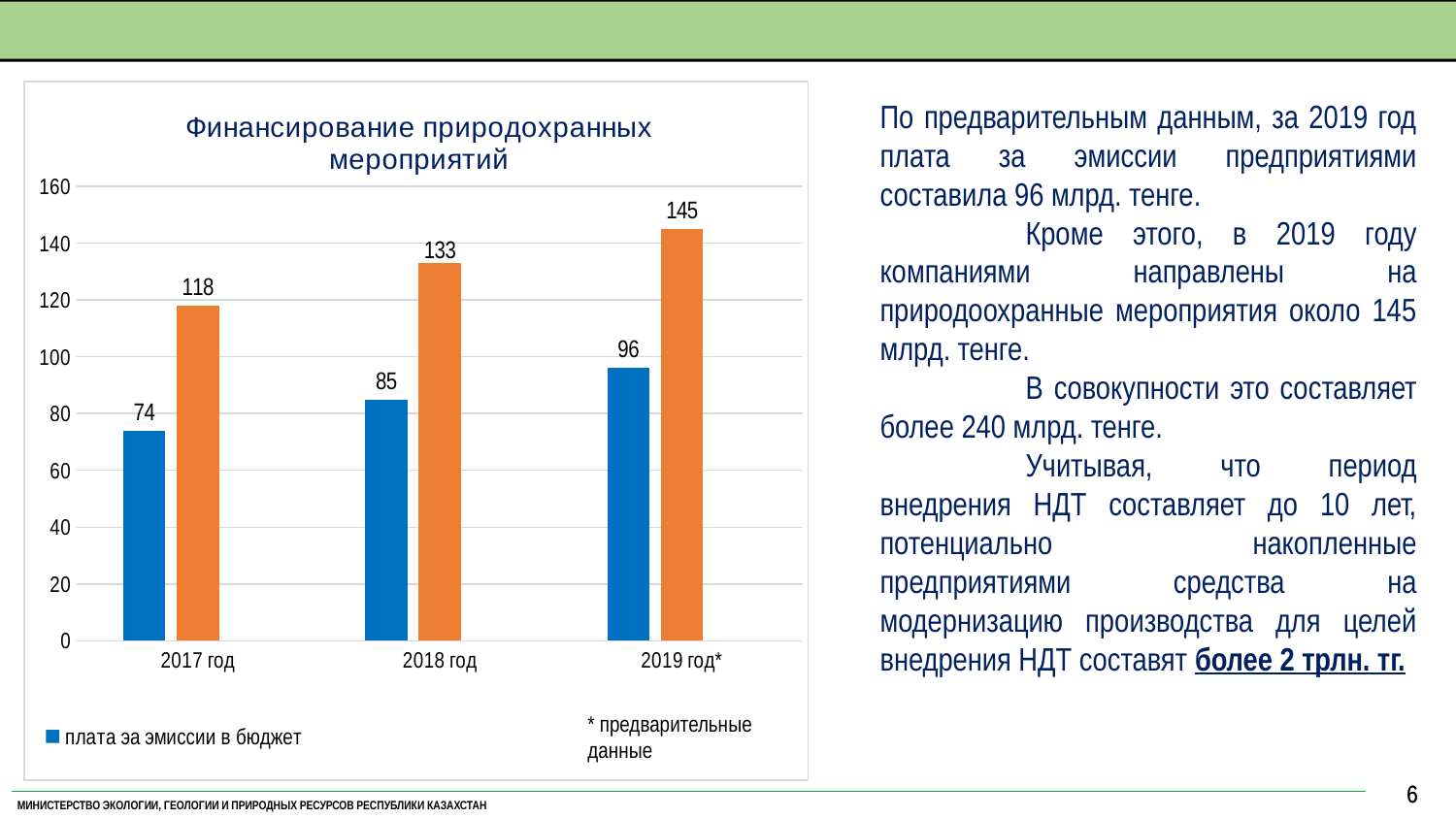
Which is larger for 2017 год: the blue bar or the orange bar? the orange bar What is the value of the orange bar for 2018 год? 133 What is the difference between the orange bar and the blue bar for 2018 год? 48 How many year categories are shown on the x axis? 3 What is the value of the orange bar for 2019 год*? 145 In which year is the orange bar lowest? 2017 год Do the values of 'плата за эмиссии в бюджет' rise or fall from 2017 год to 2019 год*? rise What is the value of 'плата за эмиссии в бюджет' for 2017 год? 74 How many series does the legend list? 1 What is the value of 'плата за эмиссии в бюджет' for 2019 год*? 96 What type of chart is shown? bar chart In which year is 'плата за эмиссии в бюджет' highest? 2019 год*